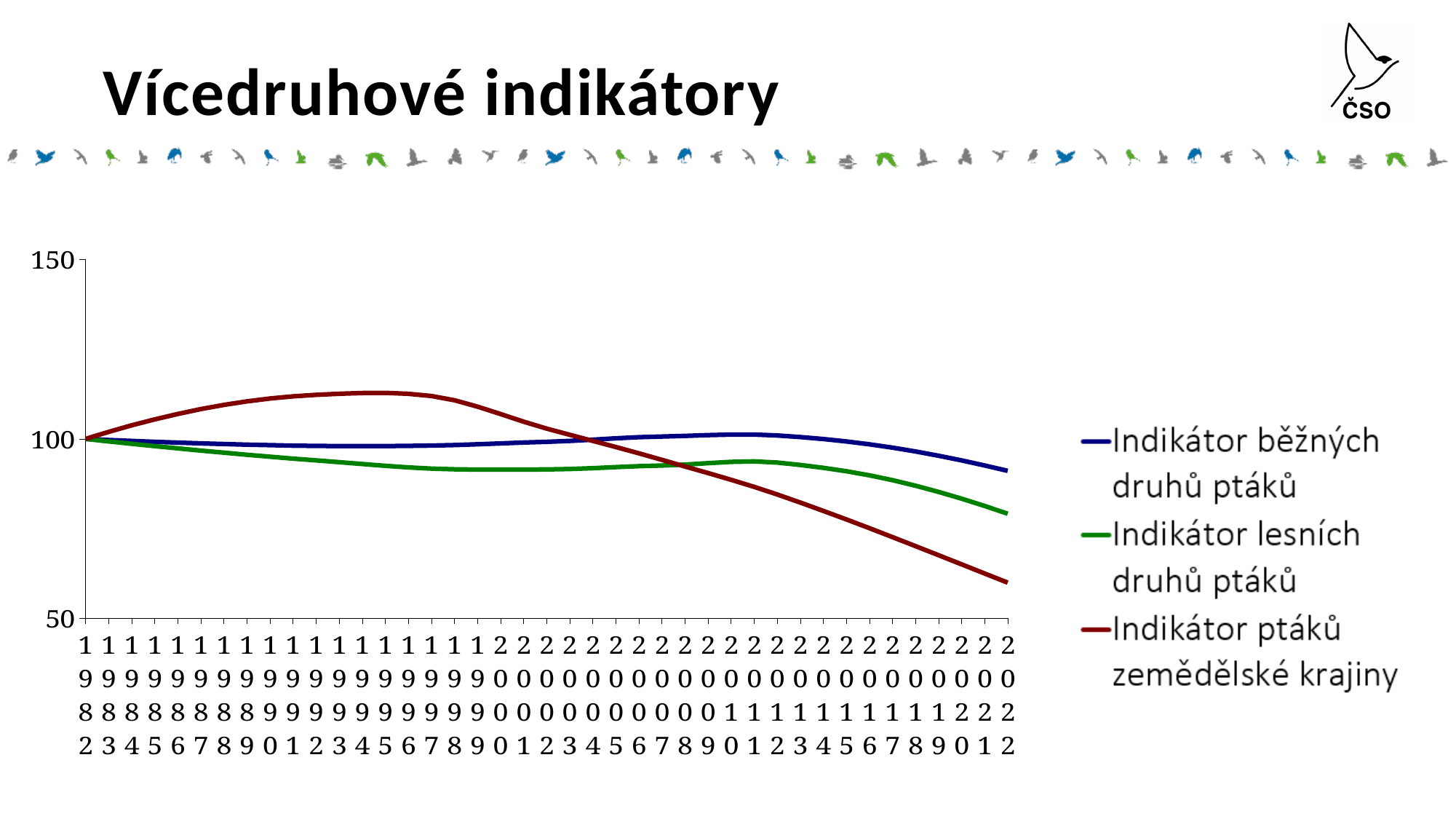
Which series has the lowest value in 2022? Indikátor ptáků zemědělské krajiny In 2022, which is higher: Indikátor běžných druhů ptáků or Indikátor ptáků zemědělské krajiny? Indikátor běžných druhů ptáků Does Indikátor ptáků zemědělské krajiny rise or fall between 2000 and 2022? fall What is the first year shown on the x axis? 1982 How many series does the legend list? 3 Is the value for Indikátor ptáků zemědělské krajiny in 2022 greater or less than 100? less How many years are shown along the x axis? 41 What is the value of Indikátor ptáků zemědělské krajiny in 1982? 100 What kind of chart is shown on the slide? line chart Is the value for Indikátor lesních druhů ptáků in 2022 greater or less than 100? less What is the value of Indikátor lesních druhů ptáků in 1982? 100 Is the value for Indikátor ptáků zemědělské krajiny in 1995 greater or less than 100? greater